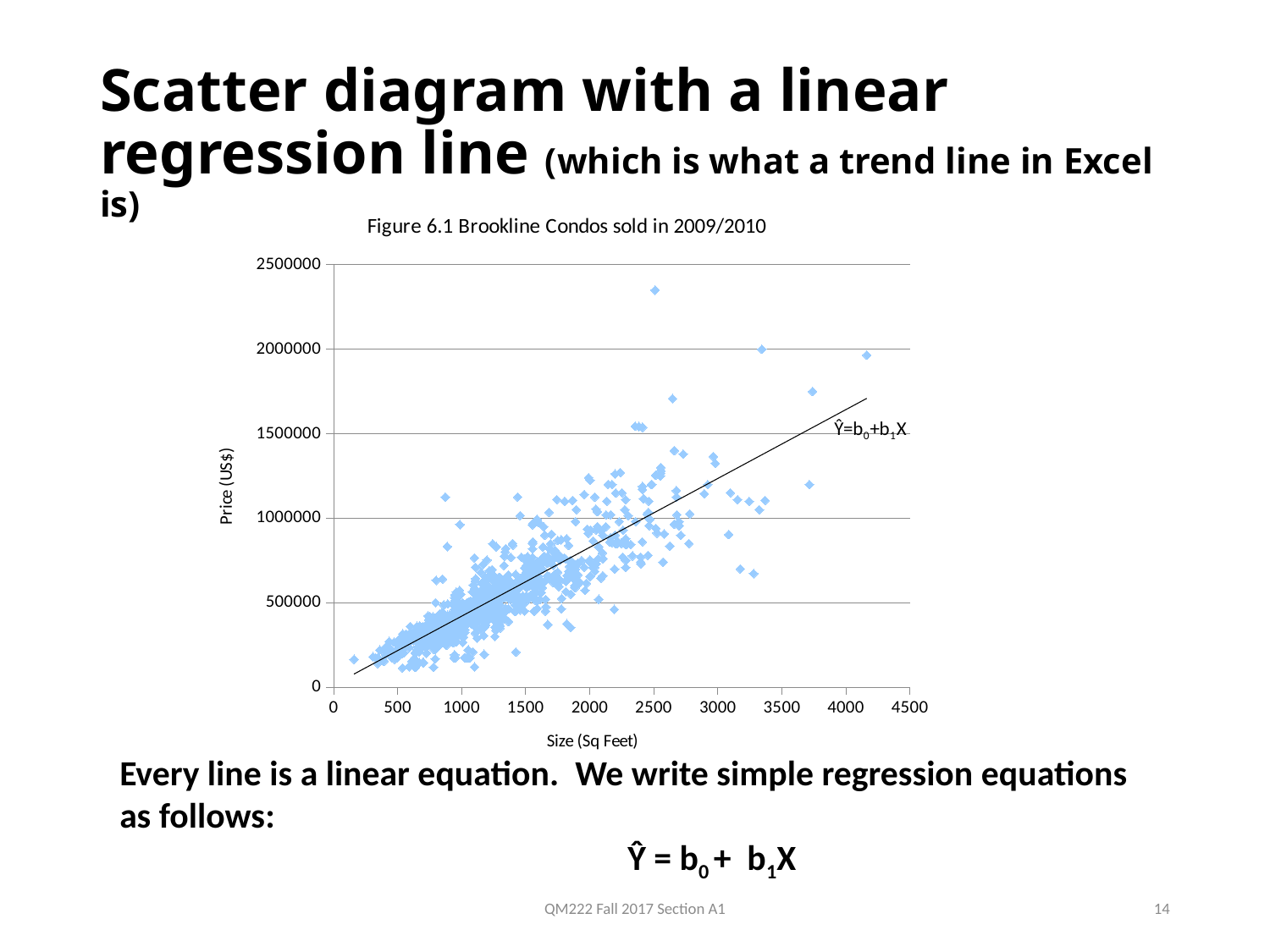
What is the title of the chart? Figure 6.1 Brookline Condos sold in 2009/2010 What kind of chart is shown on the slide? Scatter chart Do condo prices generally rise or fall as size increases along the x axis? Rise Is the price of the leftmost point on the chart greater or less than 500000? less What label is shown on the x axis of the chart? Size (Sq Feet) Is the price of the highest point on the chart greater or less than 2000000? greater What is the highest value shown on the x axis of the chart? 4500 Is the price of the rightmost point on the chart greater or less than 1500000? greater What is the highest value shown on the y axis of the chart? 2500000